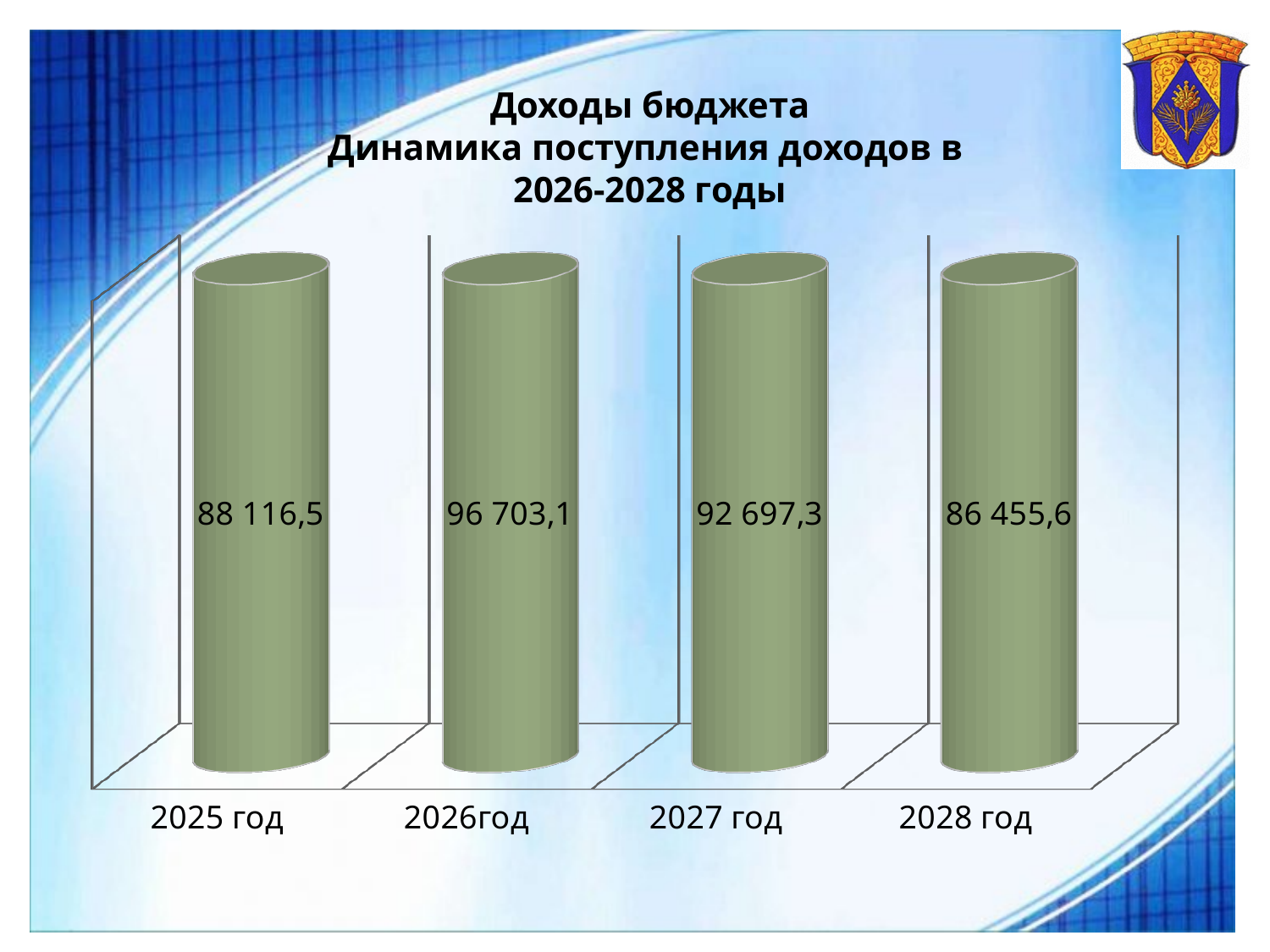
What is the difference between the values for 2026год and 2025 год? 8 586,6 What is the value shown for 2027 год? 92 697,3 Which year has the lowest value on the chart? 2028 год Which year has the highest value on the chart? 2026год Which is larger, the value for 2025 год or the value for 2028 год? 2025 год What is the value shown for 2025 год? 88 116,5 What is the difference between the values for 2027 год and 2028 год? 6 241,7 Do the values rise or fall from 2026год to 2028 год? Fall What is the value shown for 2026год? 96 703,1 What kind of chart is shown on the slide? Bar chart What is the value shown for 2028 год? 86 455,6 How many years (categories) are shown on the chart? 4